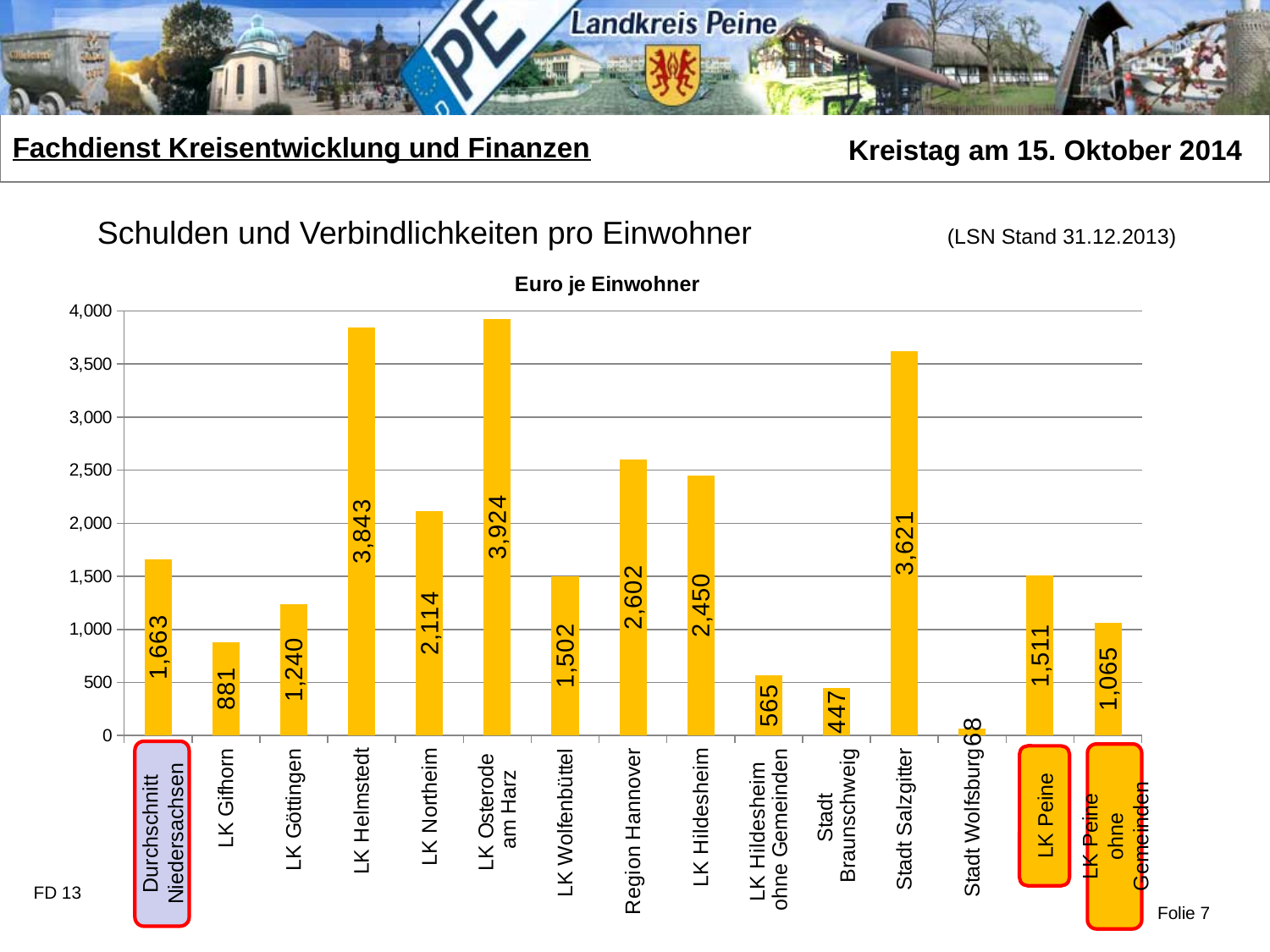
What is the value for Stadt Salzgitter? 3,621 What is the difference between the values for Durchschnitt Niedersachsen and LK Peine? 152 Is the value for LK Northeim greater or less than 2,000? greater What is the title of the chart? Euro je Einwohner What is the value for Durchschnitt Niedersachsen? 1,663 What is the value for LK Hildesheim ohne Gemeinden? 565 Which category has the lowest value? Stadt Wolfsburg Which is larger, the value for LK Helmstedt or the value for Stadt Salzgitter? LK Helmstedt What kind of chart is shown? bar chart How many categories are shown on the x axis? 15 Which category has the highest value? LK Osterode am Harz What is the value for LK Peine? 1,511